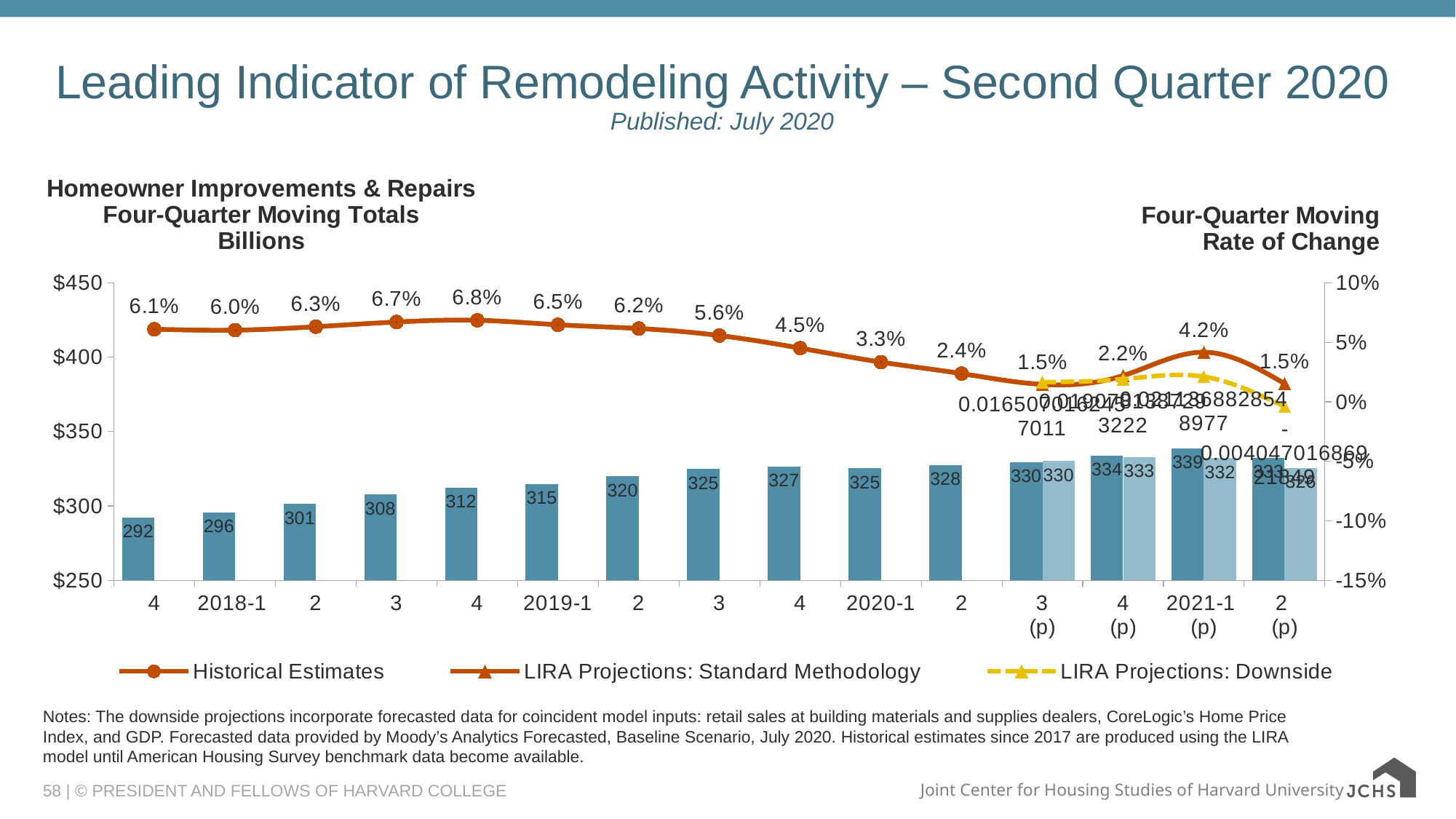
What kind of chart is this? Combination bar and line chart How many series does the legend list? 3 What is the highest Historical Estimates rate of change shown on the chart? 6.8% What is the value of the lowest dark blue bar on the chart? 292 What is the Historical Estimates rate of change for 2019-1? 6.5% Which has a higher Historical Estimates rate of change: 2020-1 or the following quarter 2? 2020-1 What is the difference between the dark blue bar values for 2020-1 and 2019-1? 10 How many quarter categories are shown along the x axis? 15 Which legend entry is drawn as a dashed yellow line? LIRA Projections: Downside What is the four-quarter moving total (in billions) shown on the bar for 2018-1? 296 What is the LIRA Projections: Standard Methodology rate of change for 2021-1 (p)? 4.2% Does the Historical Estimates rate of change rise or fall from 2019-1 through 2020 quarter 2? Fall